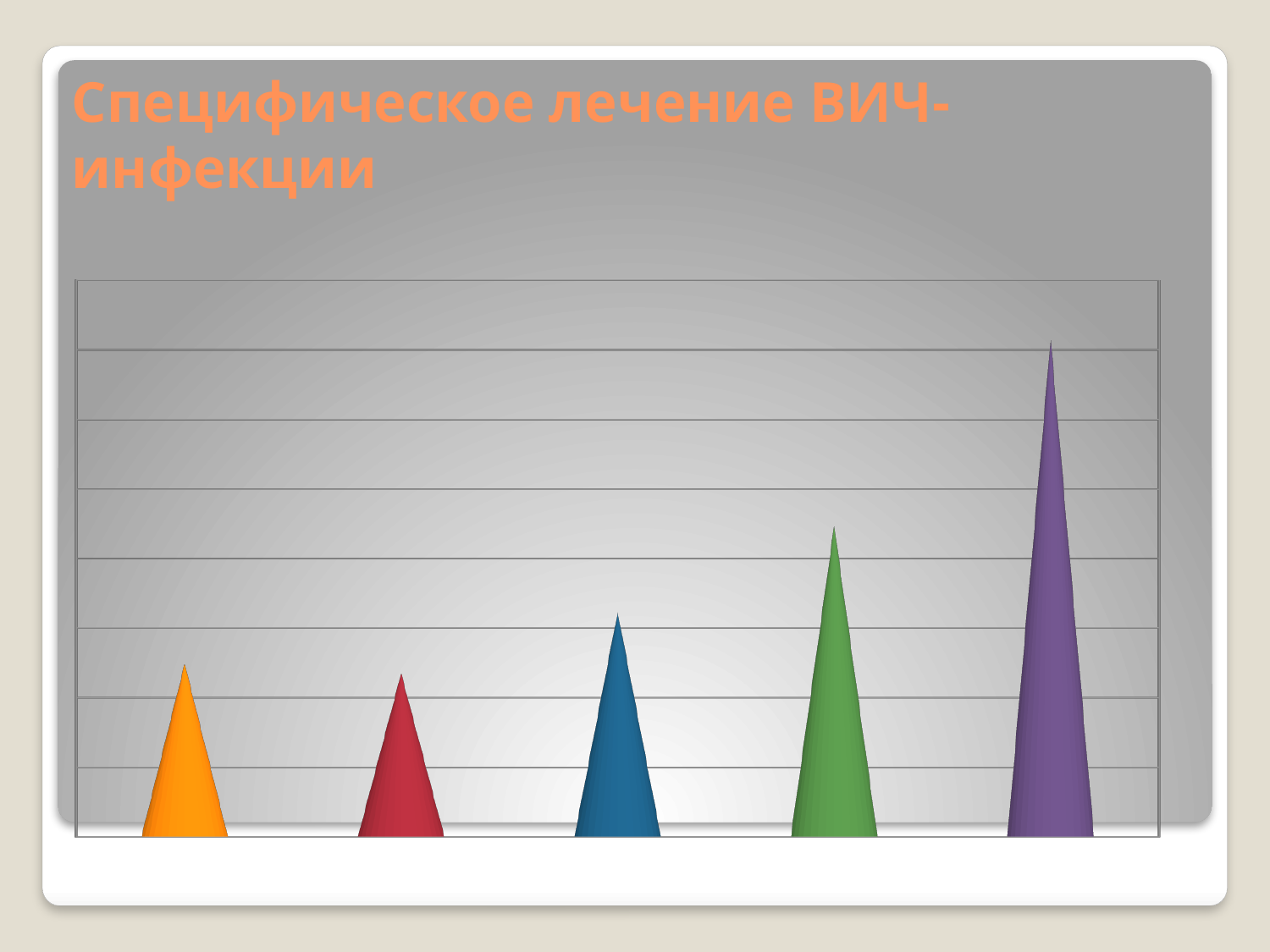
Which bar reaches the highest value in the chart, by its position? the rightmost bar What is the title of the slide containing the chart? Специфическое лечение ВИЧ-инфекции Which bar is the tallest in the chart: the leftmost (orange) or the rightmost (purple)? the rightmost (purple) Which is taller, the blue bar or the green bar? the green bar How many bars does the chart contain? 5 Which is taller, the green bar or the purple bar? the purple bar Which is taller, the red bar or the blue bar? the blue bar What colour is the tallest bar in the chart? purple Do the bars generally rise or fall from the third bar to the fifth bar? rise What kind of chart is shown on the slide? bar chart